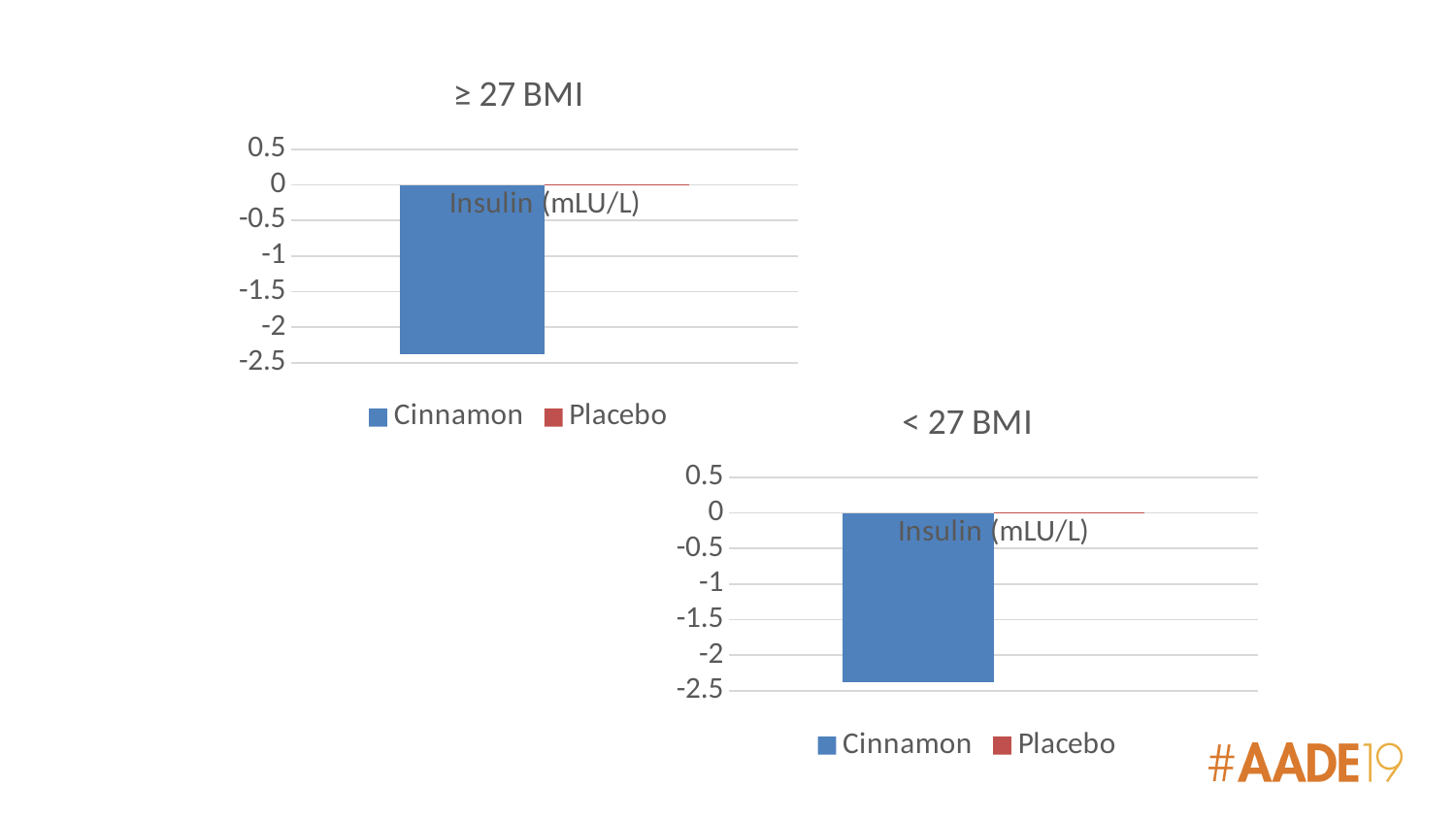
In the "< 27 BMI" chart, how many categories are plotted on the x axis? 1 In the "< 27 BMI" chart, which series has the lower value? Cinnamon In the "≥ 27 BMI" chart, which series has the larger value, Cinnamon or Placebo? Placebo In the "< 27 BMI" chart, which series is shown in blue? Cinnamon In the "< 27 BMI" chart, is the value for Cinnamon greater or less than -2? less In the "≥ 27 BMI" chart, is the value for Cinnamon greater or less than -2? less In the "≥ 27 BMI" chart, what kind of chart is shown? bar chart In the "≥ 27 BMI" chart, is the value for Cinnamon greater or less than -1? less In the "≥ 27 BMI" chart, what is the label of the category on the x axis? Insulin (mLU/L) In the "< 27 BMI" chart, how many series does the legend list? 2